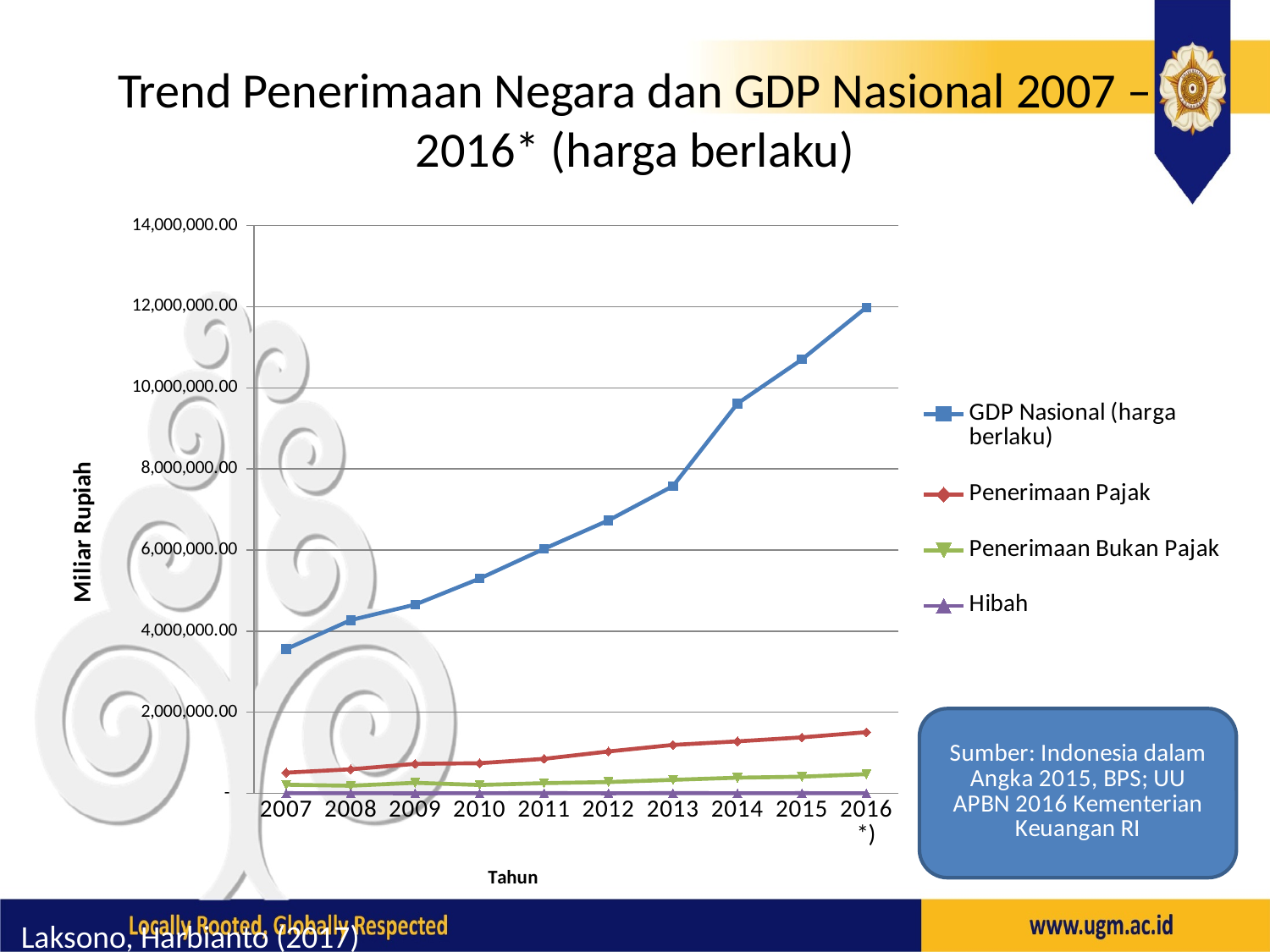
How many years are plotted along the x axis? 10 Is the value for GDP Nasional (harga berlaku) in 2016 greater or less than 10,000,000.00? greater Is the value for GDP Nasional (harga berlaku) in 2013 greater or less than 8,000,000.00? less In which year is GDP Nasional (harga berlaku) lowest? 2007 What is the title of the vertical axis? Miliar Rupiah How many series does the legend list? 4 Does the GDP Nasional (harga berlaku) series rise or fall from 2007 to 2016? rise Is the value for GDP Nasional (harga berlaku) in 2007 greater or less than 4,000,000.00? less What kind of chart is shown on the slide? line chart In which year is GDP Nasional (harga berlaku) highest? 2016 Which series has the larger value in 2016, GDP Nasional (harga berlaku) or Penerimaan Pajak? GDP Nasional (harga berlaku)